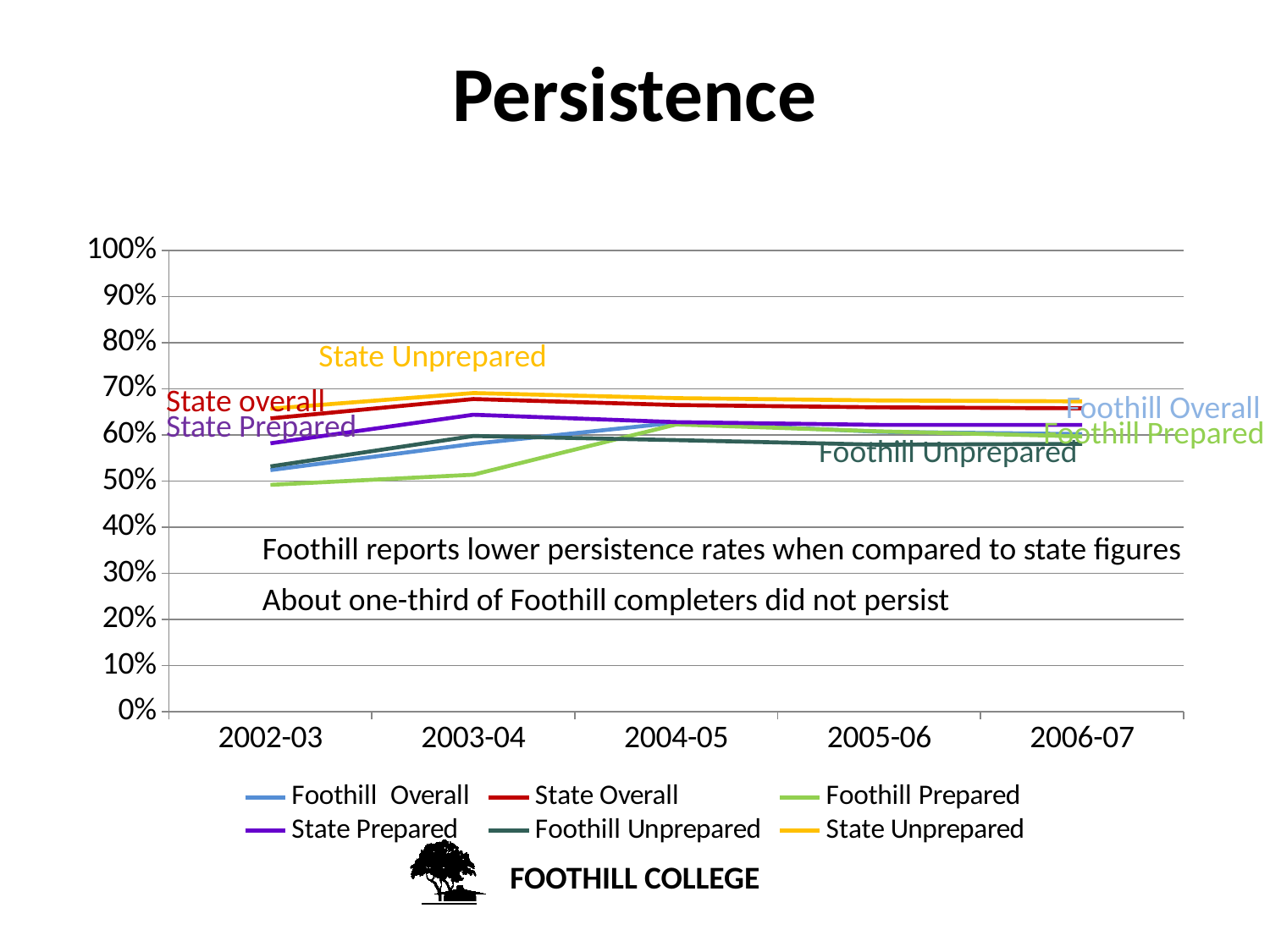
What kind of chart is shown on the slide? line chart Which series has the lowest value in 2003-04? Foothill Prepared What is the title of the chart? Persistence How many series does the legend list? 6 In 2003-04, which is larger: State Unprepared or Foothill Prepared? State Unprepared Is the value for Foothill Overall in 2002-03 greater or less than 60%? less Is the value for Foothill Unprepared in 2002-03 greater or less than 60%? less Which series is drawn in yellow? State Unprepared Is the value for State Unprepared in 2003-04 greater or less than 60%? greater Does the Foothill Prepared line rise or fall from 2002-03 to 2004-05? rise Which series has the highest value in 2002-03? State Unprepared How many academic years are shown on the x axis? 5